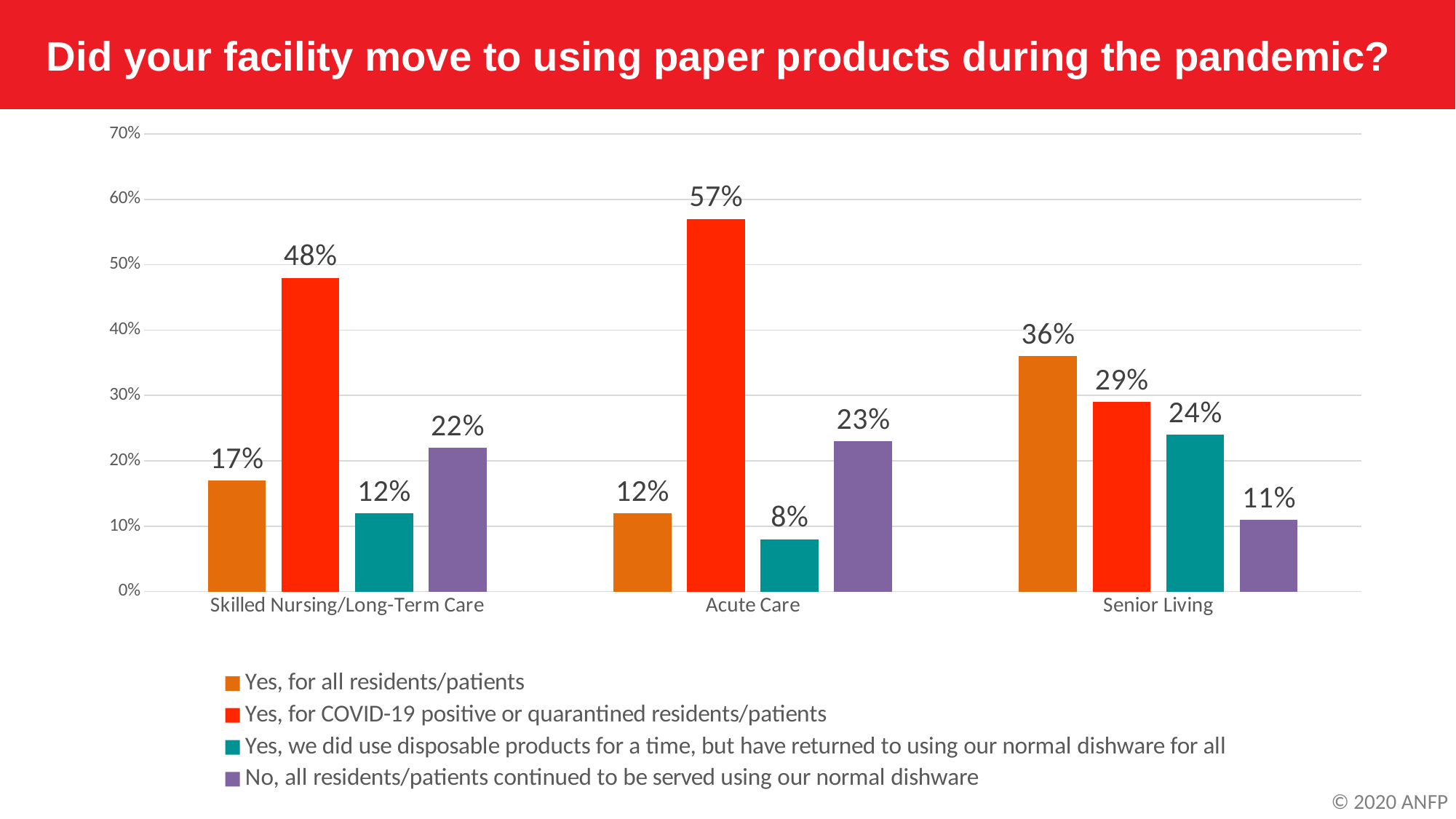
What percentage of Senior Living facilities answered 'Yes, for all residents/patients'? 36% What percentage of Skilled Nursing/Long-Term Care facilities answered 'No, all residents/patients continued to be served using our normal dishware'? 22% What kind of chart is shown on the slide? Bar chart What is the difference between the 'Yes, for COVID-19 positive or quarantined residents/patients' values for Acute Care and Skilled Nursing/Long-Term Care? 9% Is the value for 'Yes, for COVID-19 positive or quarantined residents/patients' in Skilled Nursing/Long-Term Care greater or less than 40%? greater Which response has the lowest value for Acute Care? Yes, we did use disposable products for a time, but have returned to using our normal dishware for all What percentage of Acute Care facilities answered 'Yes, for COVID-19 positive or quarantined residents/patients'? 57% How many series does the legend list? 4 Which facility type has the highest value for 'Yes, for COVID-19 positive or quarantined residents/patients'? Acute Care How many facility types are shown on the x axis? 3 What is the title of the chart? Did your facility move to using paper products during the pandemic? Which is larger for Senior Living: 'Yes, for all residents/patients' or 'Yes, for COVID-19 positive or quarantined residents/patients'? Yes, for all residents/patients